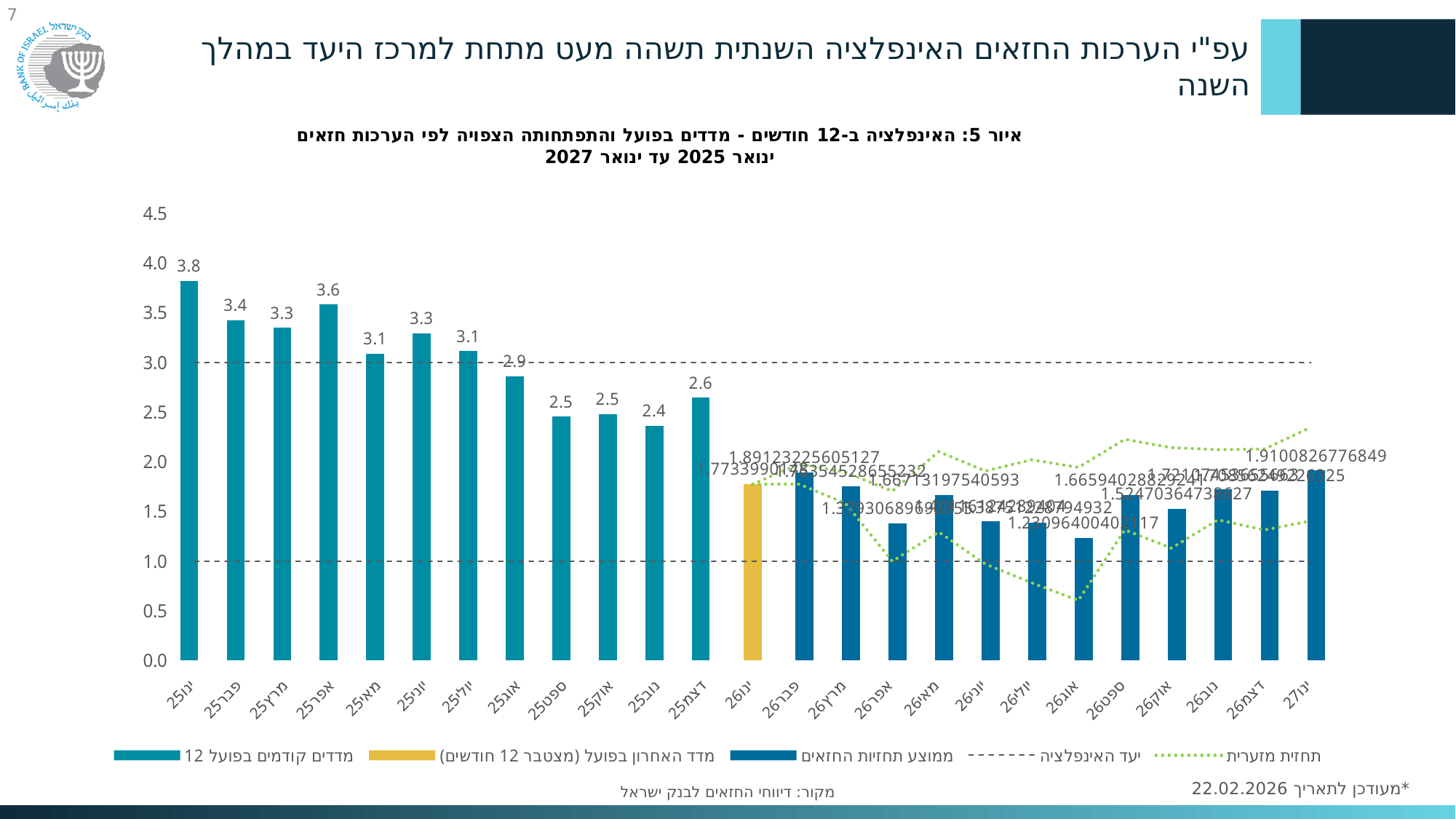
What is the value of the bar for ינו25? 3.8 Which month has the highest bar in the chart? ינו25 Among the 2025 months, which has the lowest bar? נוב25 Is the value of the bar for אוג26 greater or less than 1.5? less Do the bar values rise or fall from ינו25 to נוב25? fall How many months are shown on the x axis? 25 Is the value of the bar for ינו26 greater or less than 2.0? less How many entries does the legend list? 5 What is the difference between the bars for ינו25 and נוב25? 1.4 Which bar is higher, פבר25 or מרץ25? פבר25 What is the value of the bar for אפר25? 3.6 What is the value of the bar for דצמ25? 2.6